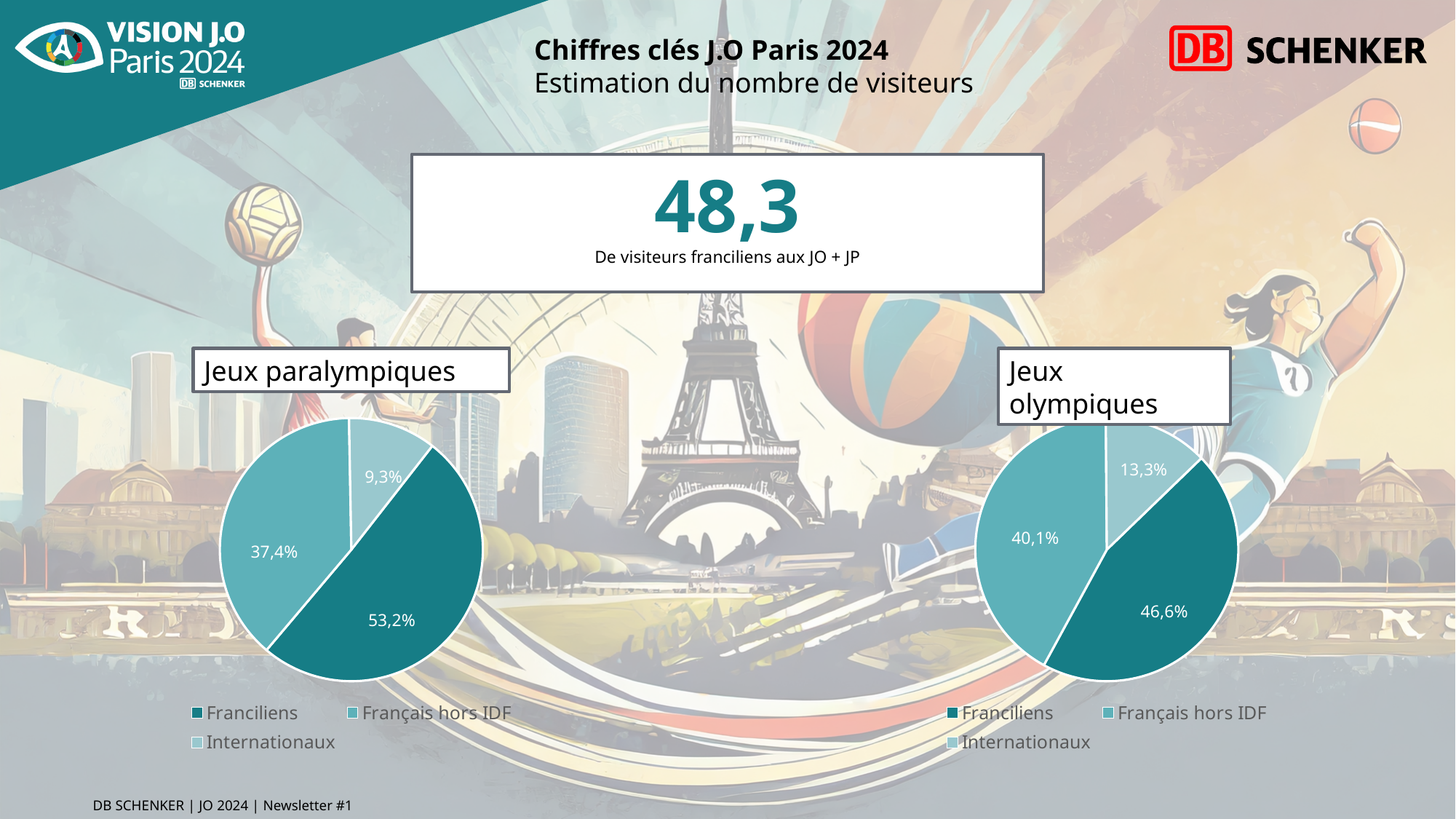
In the 'Jeux olympiques' chart, what is the difference between the Franciliens share and the Français hors IDF share? 6,5% How many categories does the 'Jeux olympiques' chart show? 3 How many entries does the legend of the 'Jeux paralympiques' chart list? 3 In the 'Jeux paralympiques' chart, what share do Internationaux represent? 9,3% Is the Internationaux share larger in the 'Jeux paralympiques' chart or in the 'Jeux olympiques' chart? Jeux olympiques In the 'Jeux olympiques' chart, what share do Français hors IDF represent? 40,1% In the 'Jeux olympiques' chart, which category has the smallest slice? Internationaux In the 'Jeux paralympiques' chart, what share do Franciliens represent? 53,2% What type of chart is used for 'Jeux paralympiques'? Pie chart In the 'Jeux paralympiques' chart, which category has the largest slice? Franciliens In the 'Jeux olympiques' chart, what share do Internationaux represent? 13,3% In the 'Jeux paralympiques' chart, what is the difference between the Français hors IDF share and the Internationaux share? 28,1%